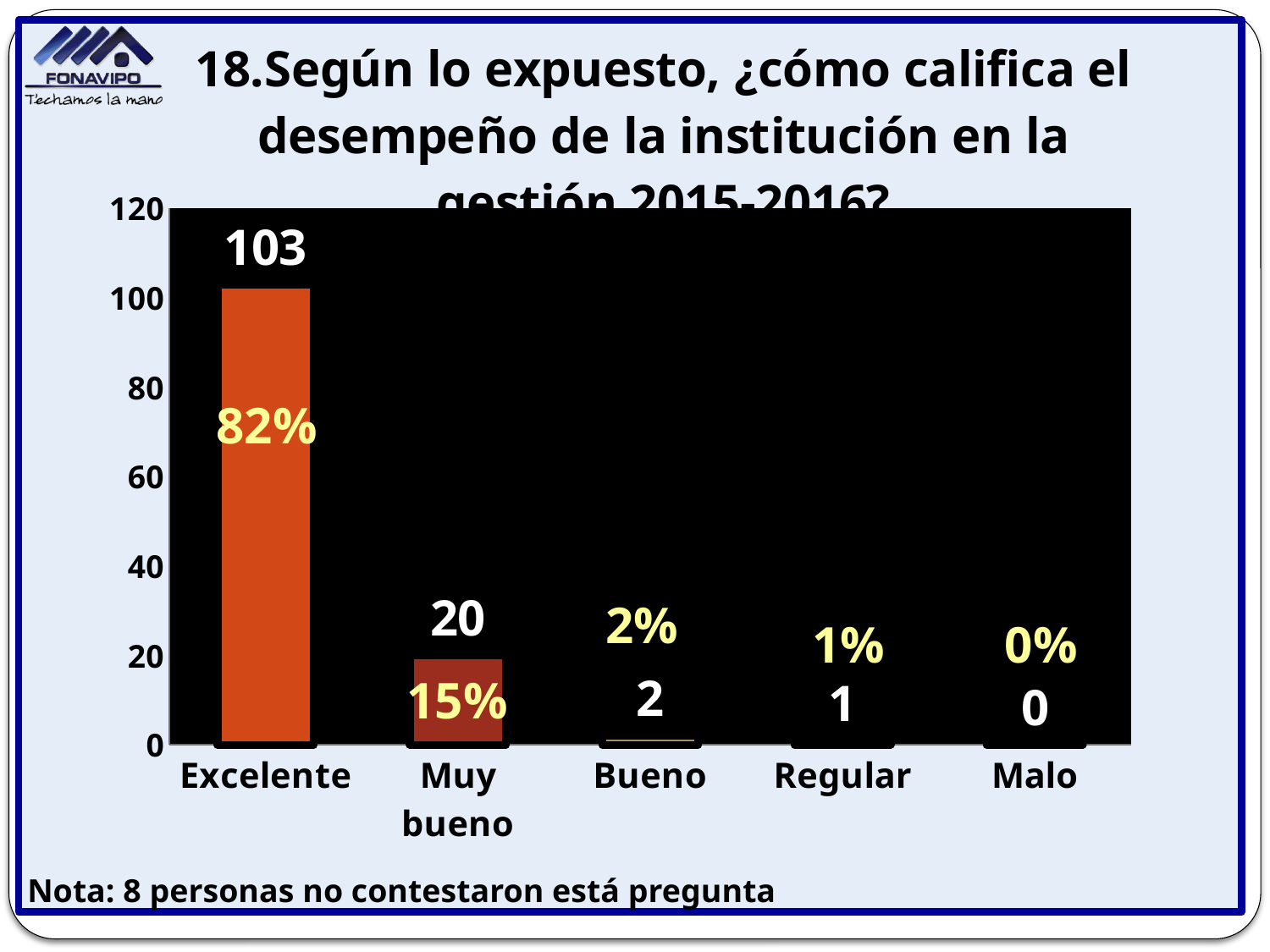
What is the value for Muy bueno? 20 Which category has the highest value? Excelente How many categories are shown on the x axis? 5 What kind of chart is shown? Bar chart What percentage is shown for Bueno? 2% What is the value for Regular? 1 Which is larger, the value for Muy bueno or the value for Bueno? Muy bueno What is the difference between the values for Excelente and Muy bueno? 83 What is the value for Excelente? 103 Which category has the lowest value? Malo What percentage is shown for Excelente? 82% Do the values rise or fall from left to right along the x axis? Fall